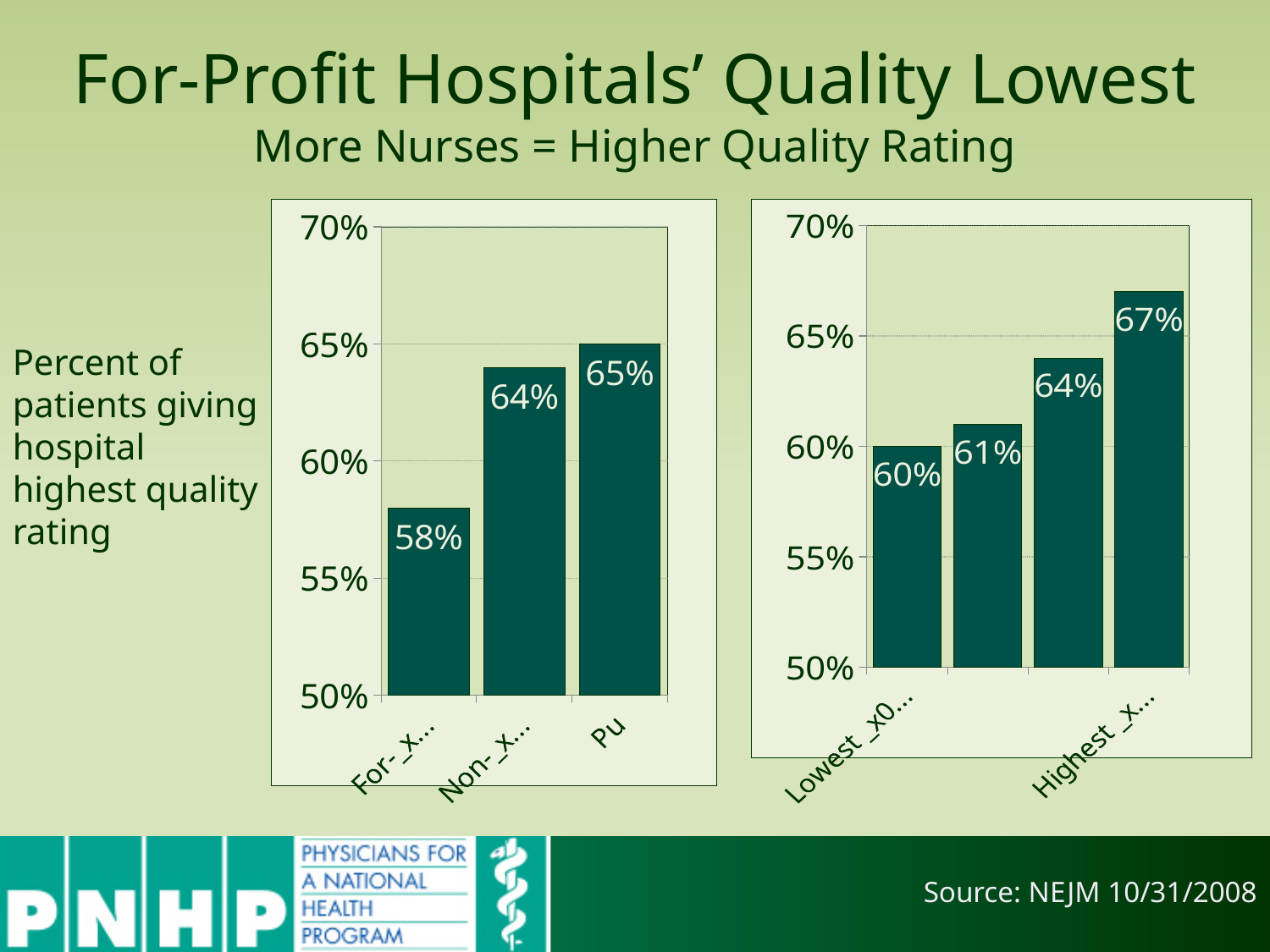
On the left chart, what is the value of the rightmost bar? 65% On the left chart, what is the value of the leftmost bar? 58% On the left chart, is the leftmost bar's value greater or less than 60%? less On the right chart, what is the value of the rightmost bar? 67% On the right chart, do the values rise or fall from left to right? rise On the left chart, what is the difference between the rightmost bar (65%) and the leftmost bar (58%)? 7% On the left chart, which bar has the lowest value? The leftmost bar (58%) On the right chart, how many bars are plotted? 4 On the right chart, what is the difference between the highest bar (67%) and the lowest bar (60%)? 7% On the right chart, what is the value of the second bar from the left? 61% On the left chart, how many bars are plotted? 3 What type of chart is shown on the left side of the slide? bar chart